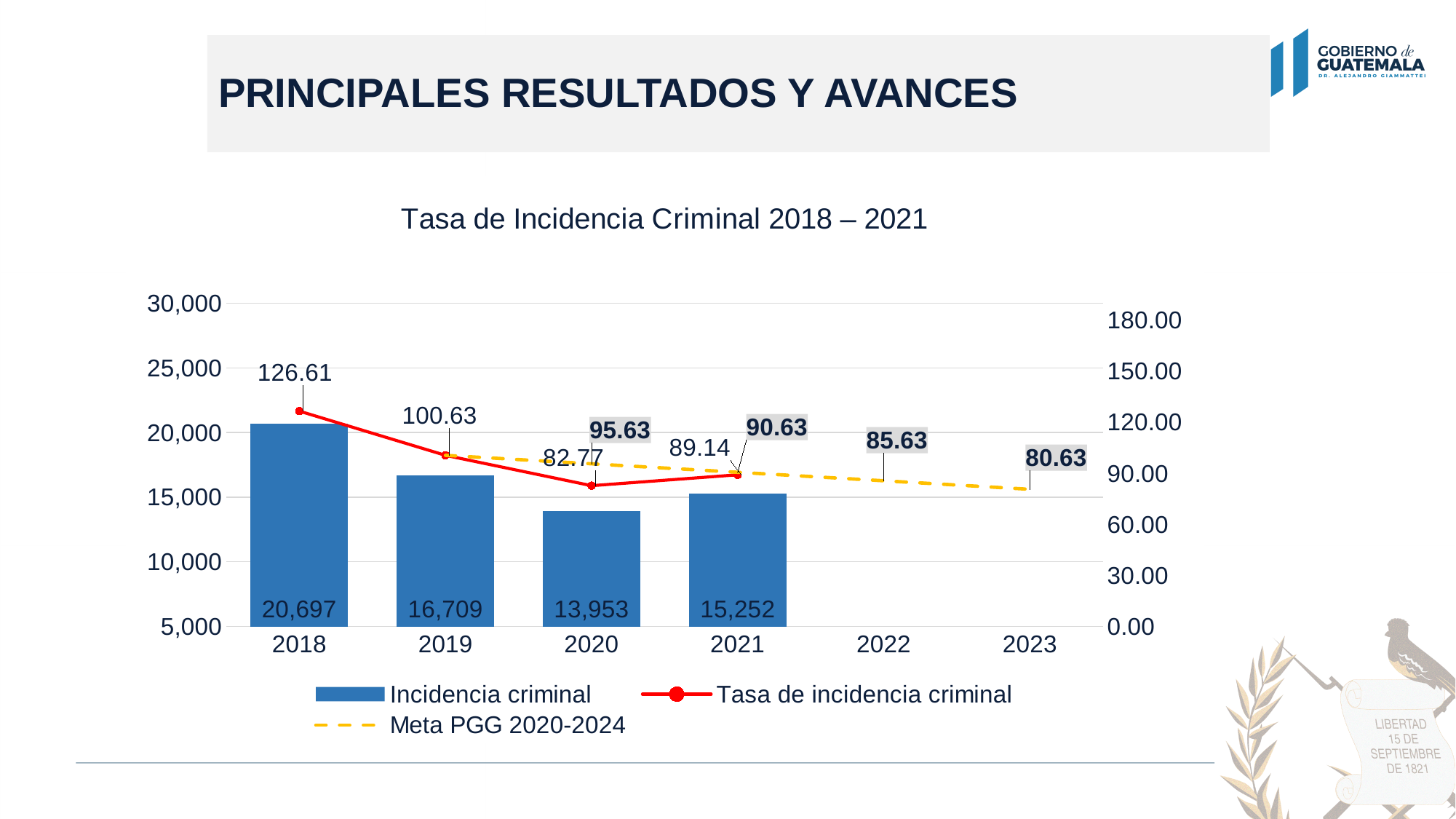
How many years have an Incidencia criminal bar plotted? 4 What is the difference in Incidencia criminal between 2018 and 2019? 3,988 What kind of chart is used for the Incidencia criminal series? Bar chart What is the title of the chart? Tasa de Incidencia Criminal 2018 – 2021 Which is larger, the Tasa de incidencia criminal for 2021 or the Meta PGG 2020-2024 for 2021? Meta PGG 2020-2024 for 2021 What is the Meta PGG 2020-2024 value for 2023? 80.63 Which year has the lowest Incidencia criminal? 2020 Does the Meta PGG 2020-2024 line rise or fall from 2020 to 2023? Fall What is the value of Incidencia criminal for 2018? 20,697 What is the Tasa de incidencia criminal for 2020? 82.77 Which year has the highest Incidencia criminal? 2018 How many series does the legend list? 3